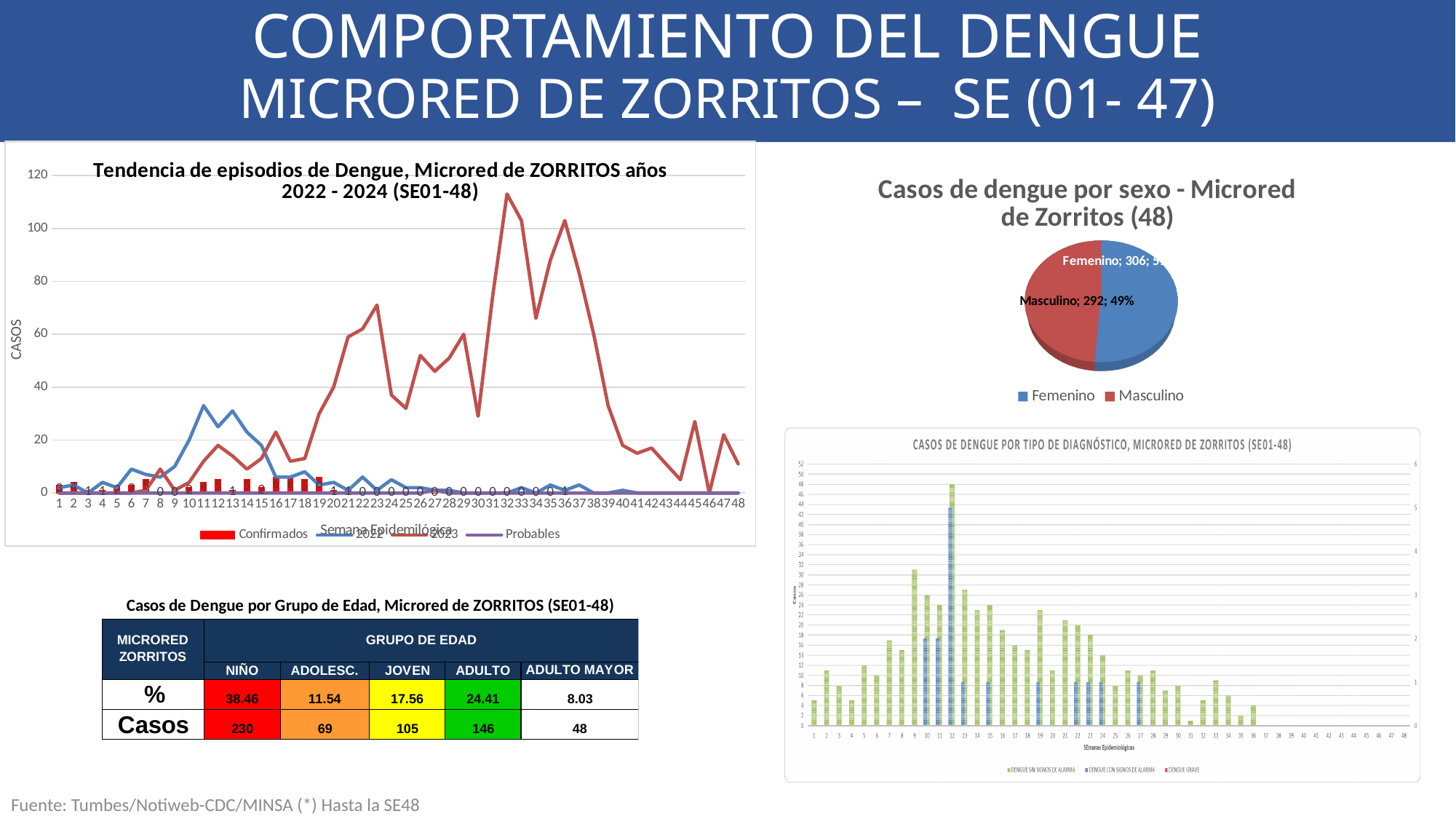
In the chart 'Tendencia de episodios de Dengue', is the value of the 2022 line at week 11 greater or less than 20? greater In the pie chart 'Casos de dengue por sexo', what percentage share is Masculino? 49% In the pie chart 'Casos de dengue por sexo', what is the difference between the Femenino and Masculino case counts? 14 In the pie chart 'Casos de dengue por sexo', which sex has more cases, Femenino or Masculino? Femenino How many series does the legend of the pie chart 'Casos de dengue por sexo' list? 2 In the chart 'Tendencia de episodios de Dengue', is the value of the 2023 line at week 32 greater or less than 100? greater In the pie chart 'Casos de dengue por sexo', how many cases are Masculino? 292 In the pie chart 'Casos de dengue por sexo', how many cases are Femenino? 306 How many series does the legend of the chart 'CASOS DE DENGUE POR TIPO DE DIAGNÓSTICO' list? 3 How many series does the legend of the chart 'Tendencia de episodios de Dengue' list? 4 What kind of chart is 'CASOS DE DENGUE POR TIPO DE DIAGNÓSTICO, MICRORED DE ZORRITOS (SE01-48)'? bar chart In the chart 'Tendencia de episodios de Dengue', does the 2023 line rise or fall between week 32 and week 39? fall